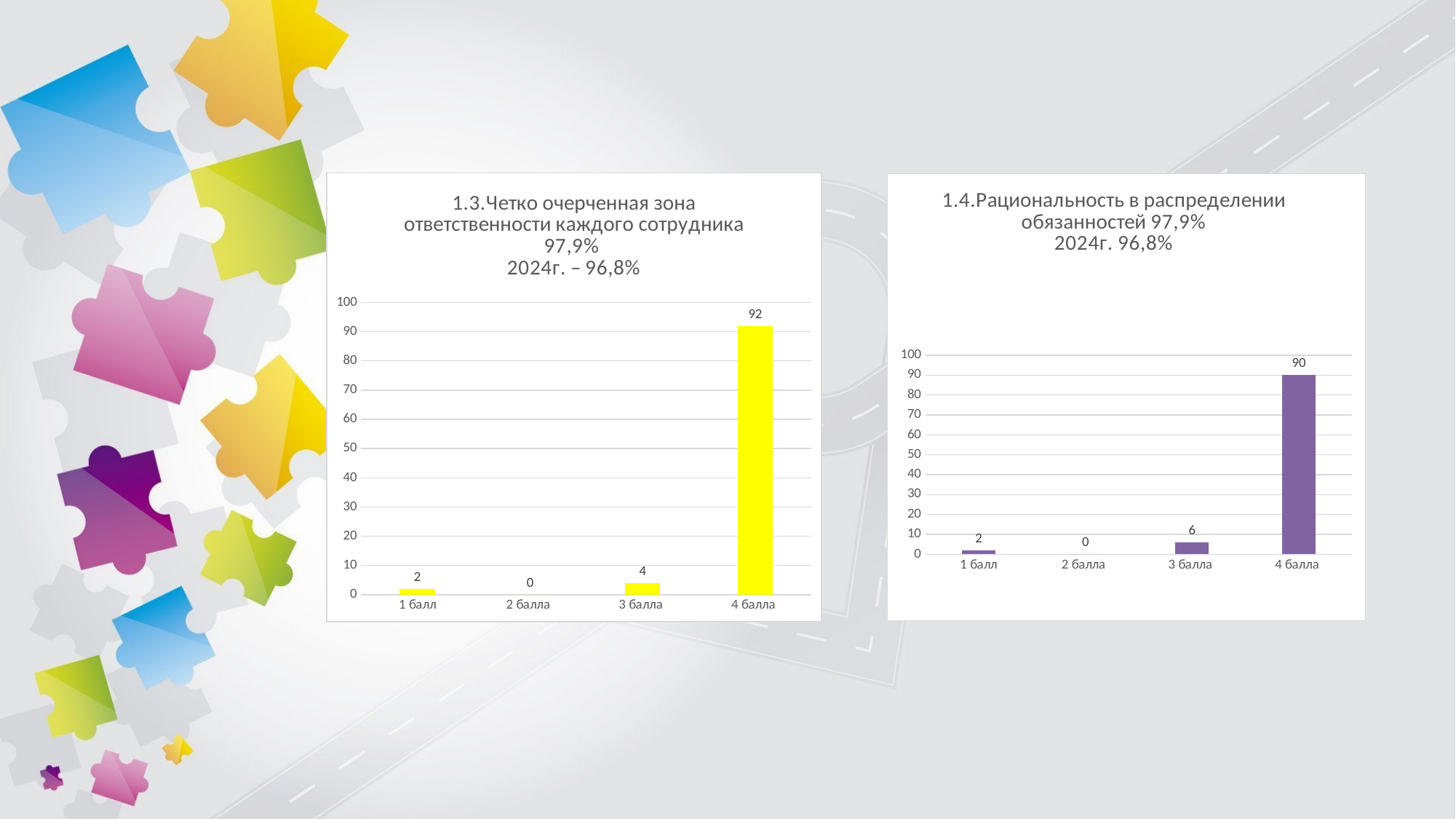
In the left chart (1.3), which category has the highest value? 4 балла In the right chart (1.4), is the value for 4 балла greater or less than 50? greater In the right chart (1.4), what is the value for 3 балла? 6 How many categories are shown on the x axis of the left chart (1.3)? 4 Which is larger: the value for 4 балла in the left chart (1.3) or the value for 4 балла in the right chart (1.4)? Left chart (1.3), 92 In the left chart (1.3), what is the value for 4 балла? 92 In the left chart (1.3), what is the difference between the values for 4 балла and 3 балла? 88 In the right chart (1.4), what is the difference between the values for 3 балла and 1 балл? 4 In the left chart (1.3), what is the value for 1 балл? 2 What colour are the bars in the left chart (1.3)? Yellow In the right chart (1.4), which category has the lowest value? 2 балла What type of chart is the right chart (1.4)? Bar chart